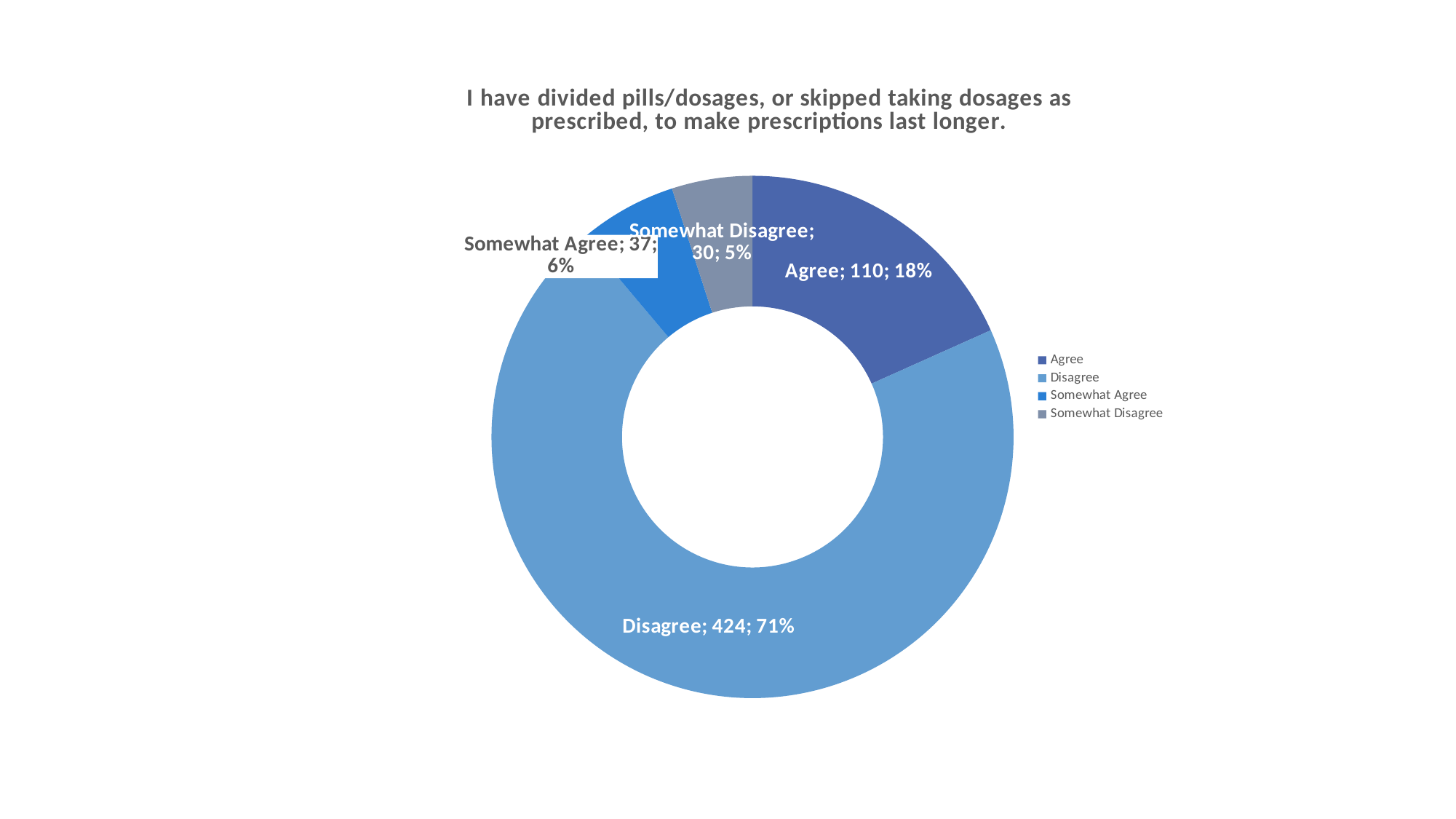
How many categories are shown in the chart? 4 What is the difference in count between Disagree and Agree? 314 Which category has the largest slice? Disagree What is the total count across all four categories? 601 What percentage share does Somewhat Disagree have? 5% Which has a larger count, Somewhat Agree or Somewhat Disagree? Somewhat Agree What kind of chart is shown on the slide? Doughnut (pie) chart What is the count for Disagree? 424 Which category has the smallest slice? Somewhat Disagree What is the title of the chart? I have divided pills/dosages, or skipped taking dosages as prescribed, to make prescriptions last longer. What percentage share does Agree have? 18% What is the count for Somewhat Agree? 37